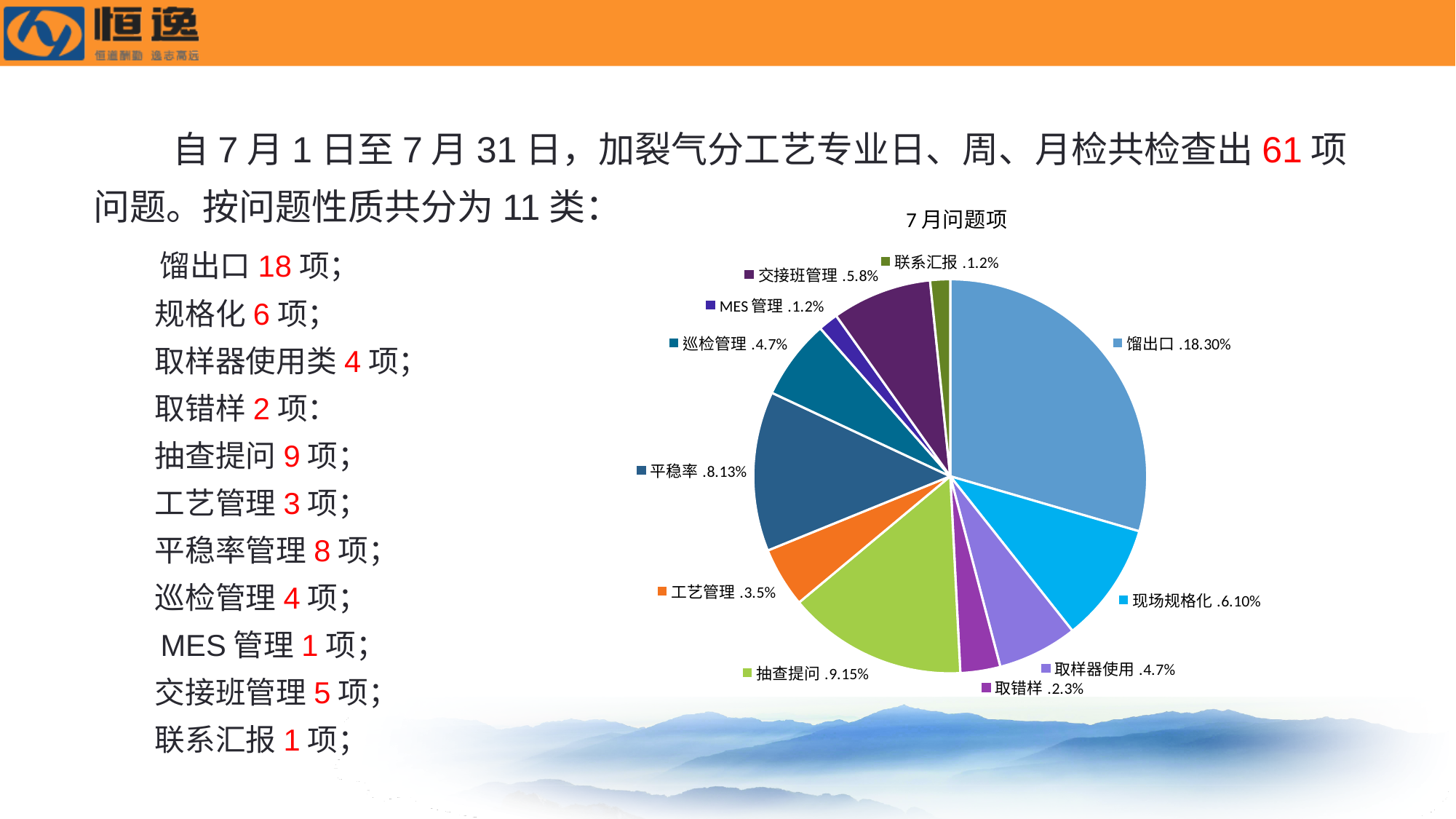
What colour is the 抽查提问 slice? light green What value is printed on the data label for 馏出口? 18.30% What is the title of the chart? 7月问题项 What value is printed on the data label for 现场规格化? 6.10% How many slices does the pie chart have? 11 What kind of chart is shown on the slide? pie chart Which category has the largest slice in the pie chart? 馏出口 What value is printed on the data label for 抽查提问? 9.15% What value is printed on the data label for 平稳率? 8.13% Which slice is larger, 平稳率 or 工艺管理? 平稳率 Which slice is larger, 馏出口 or 抽查提问? 馏出口 What value is printed on the data label for 交接班管理? 5.8%